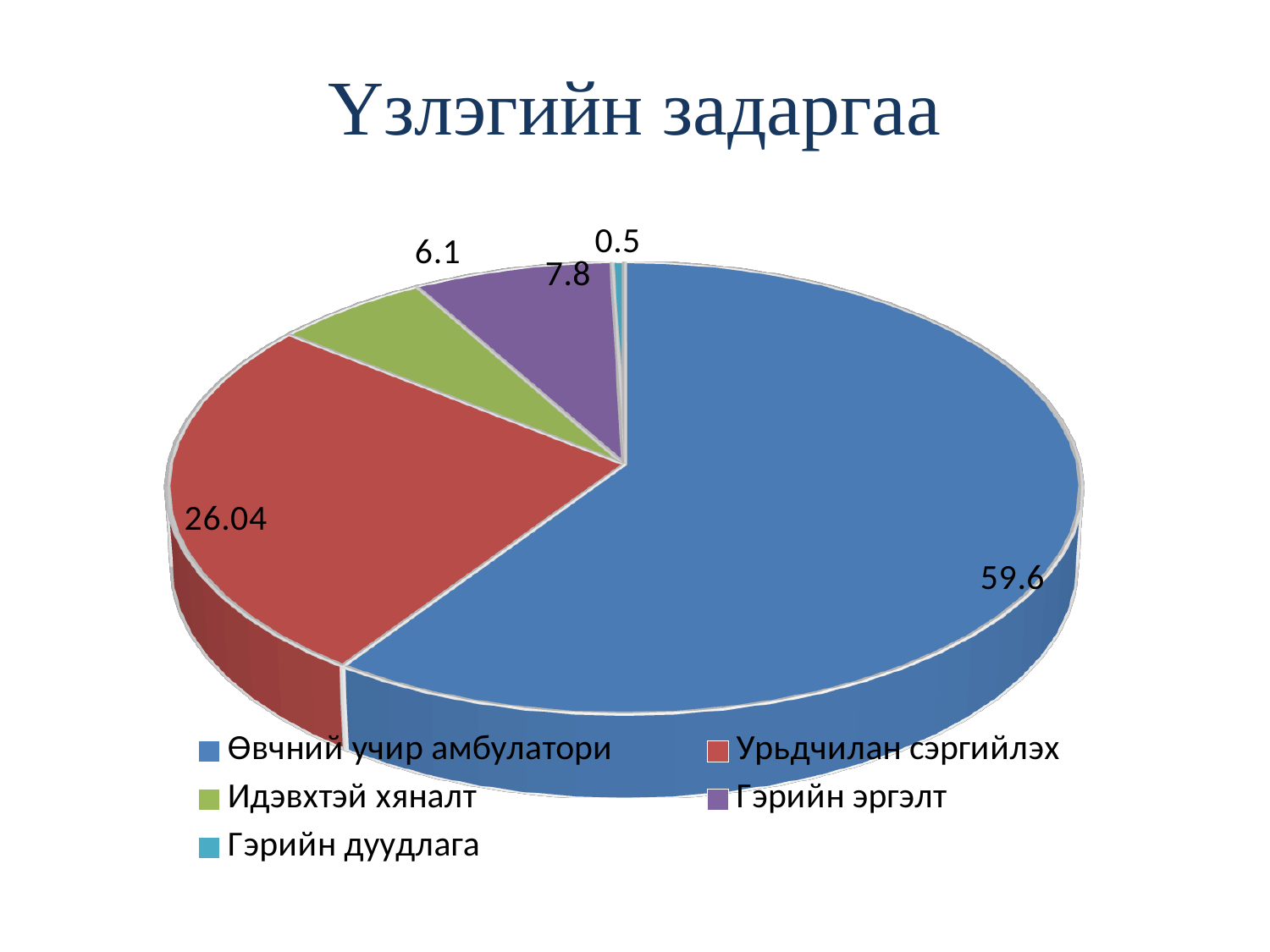
What kind of chart is shown on the slide? Pie chart What is the value for Урьдчилан сэргийлэх? 26.04 What is the value for Өвчний учир амбулатори? 59.6 What is the value for Гэрийн эргэлт? 7.8 Which category has the smallest slice? Гэрийн дуудлага What is the value for Идэвхтэй хяналт? 6.1 What is the value for Гэрийн дуудлага? 0.5 Which category has the largest slice? Өвчний учир амбулатори What is the difference between the values for Өвчний учир амбулатори and Урьдчилан сэргийлэх? 33.56 How many categories does the pie chart show? 5 Which is larger, Гэрийн эргэлт or Идэвхтэй хяналт? Гэрийн эргэлт What is the difference between the values for Гэрийн эргэлт and Идэвхтэй хяналт? 1.7